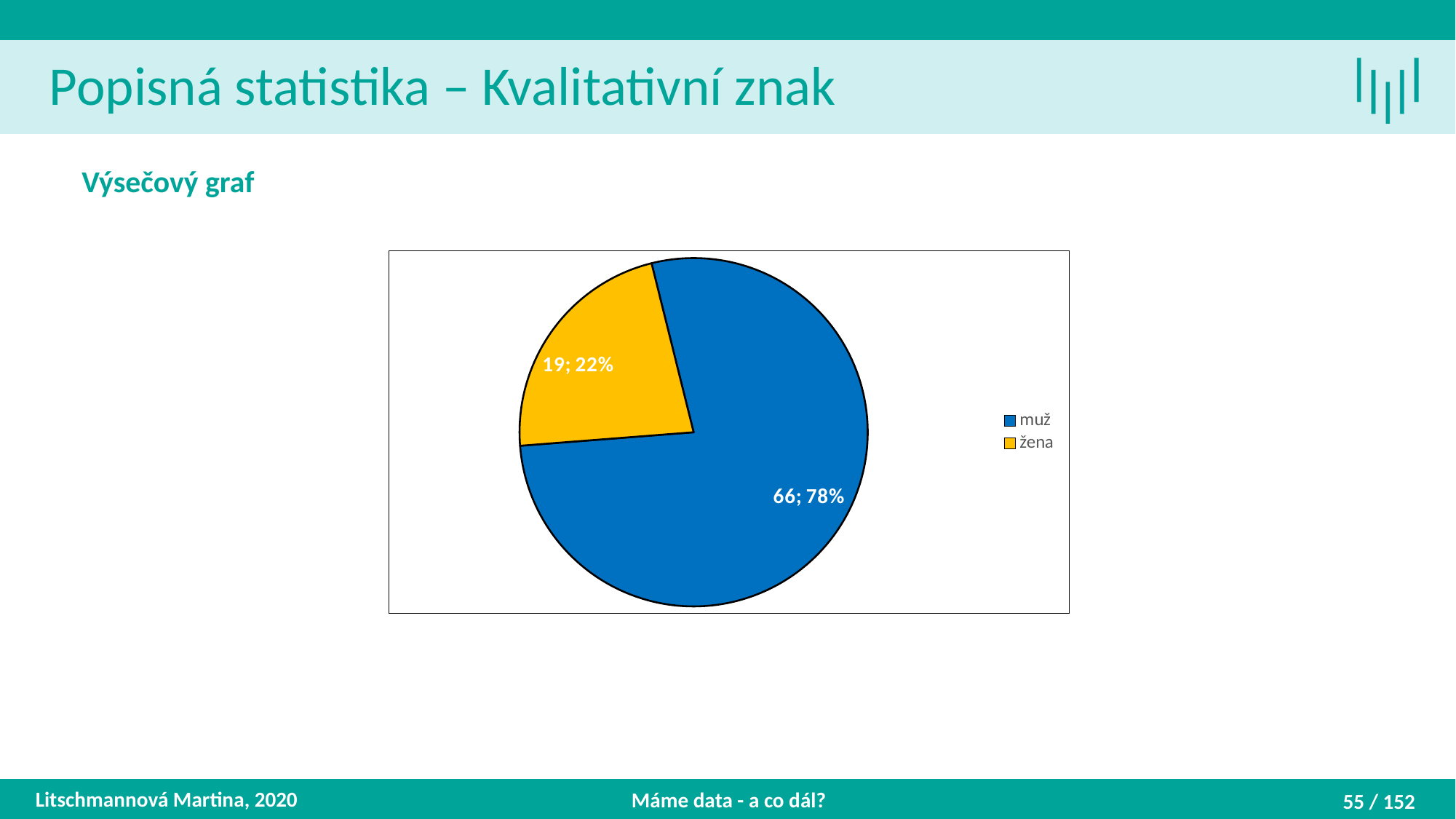
What share of the pie does the 'muž' slice represent? 78% How many entries does the legend list? 2 What kind of chart is shown on the slide? pie chart Which is larger, the count for 'muž' or for 'žena'? muž What colour is the 'žena' slice? yellow Which category has the largest slice? muž How many slices does the pie chart have? 2 What is the count shown for the 'žena' slice? 19 What share of the pie does the 'žena' slice represent? 22% Which category has the smallest slice? žena What is the count shown for the 'muž' slice? 66 What is the difference between the counts for 'muž' and 'žena'? 47